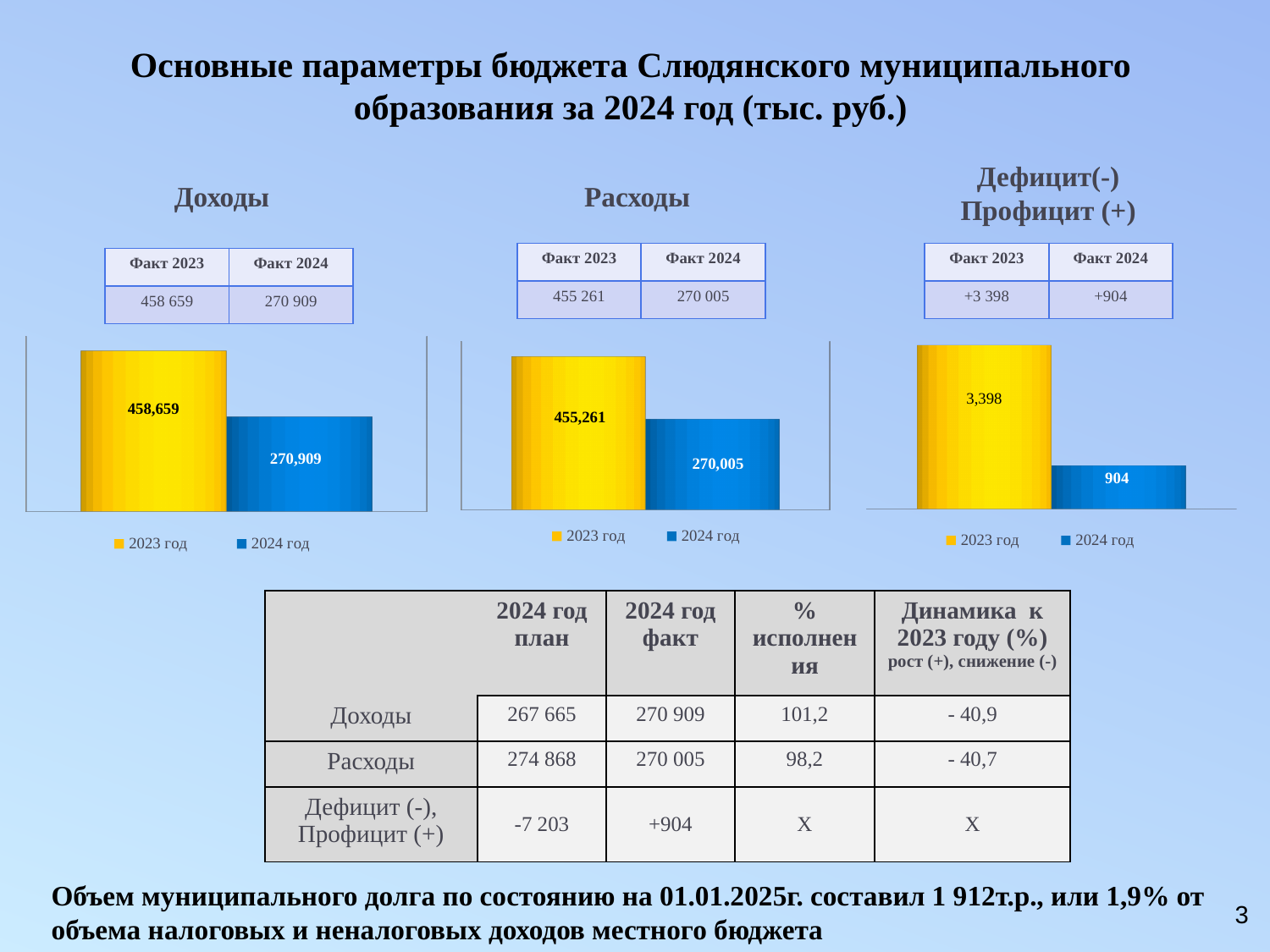
In the "Дефицит(-) Профицит (+)" chart, what is the difference between the 2023 год and 2024 год values? 2,494 In the "Доходы" chart, what is the difference between the 2023 год and 2024 год values? 187,750 How many series does the legend of the "Расходы" chart list? 2 In the "Доходы" chart, what is the value for 2023 год? 458,659 In the "Расходы" chart, what is the value for 2024 год? 270,005 In the "Дефицит(-) Профицит (+)" chart, what is the value for 2023 год? 3,398 In the "Расходы" chart, which year has the higher value? 2023 год In the "Дефицит(-) Профицит (+)" chart, what is the value for 2024 год? 904 What kind of chart is the "Доходы" chart? bar chart In the "Доходы" chart, what is the value for 2024 год? 270,909 In the "Доходы" chart, which year has the lowest value? 2024 год In the "Расходы" chart, is the value for 2023 год larger or smaller than the value for 2024 год? larger